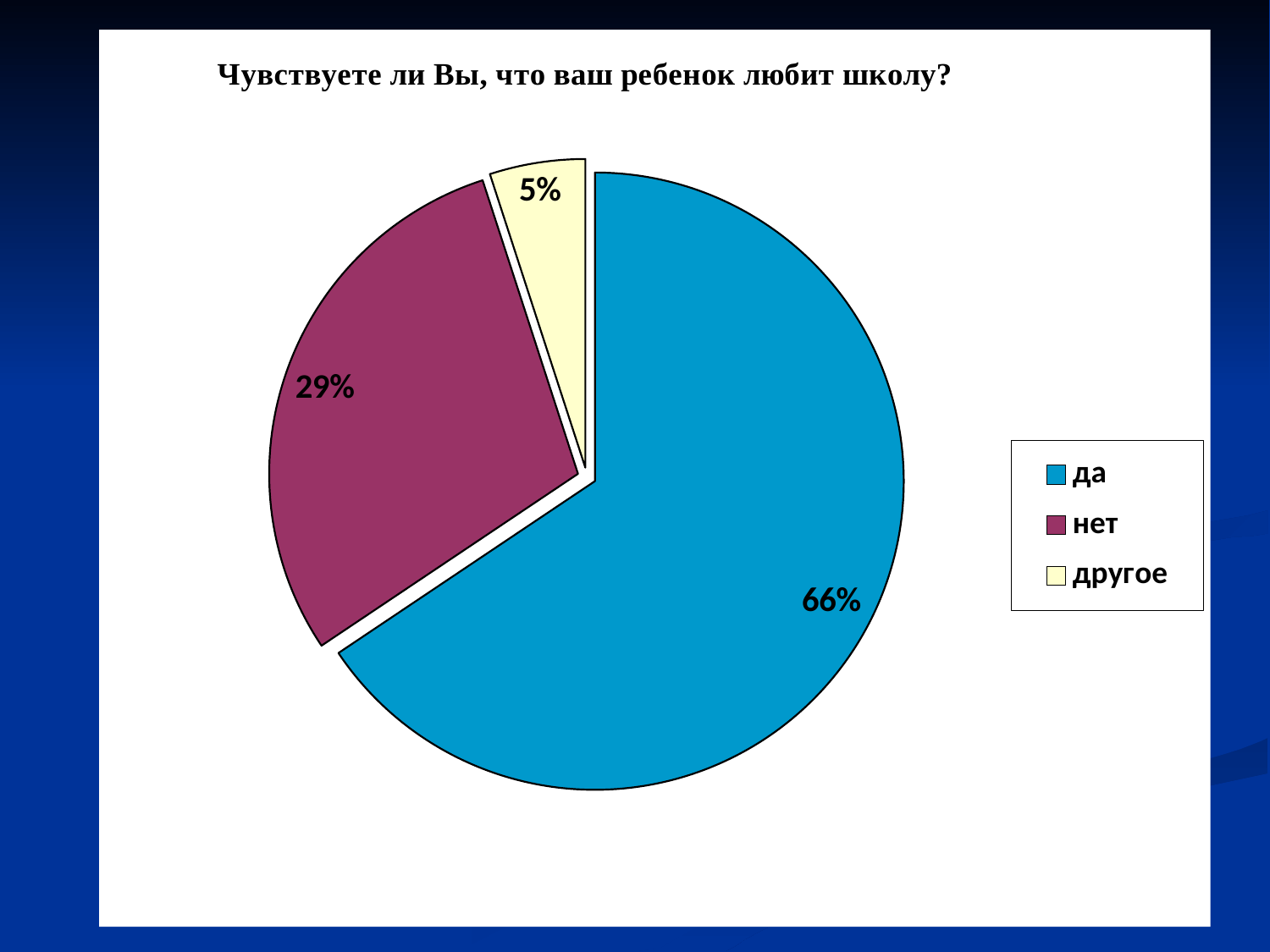
What share of the pie does "другое" have? 5% Which category has the smallest slice of the pie? другое Which category has the largest slice of the pie? да What share of the pie does "да" have? 66% What is the difference in percentage points between "да" and "нет"? 37 How many slices does the pie chart have? 3 How many entries does the legend list? 3 Which is larger, the share for "нет" or the share for "другое"? нет What kind of chart is shown on the slide? pie chart What colour is the slice for "нет"? purple What share of the pie does "нет" have? 29% What is the title of the chart? Чувствуете ли Вы, что ваш ребенок любит школу?